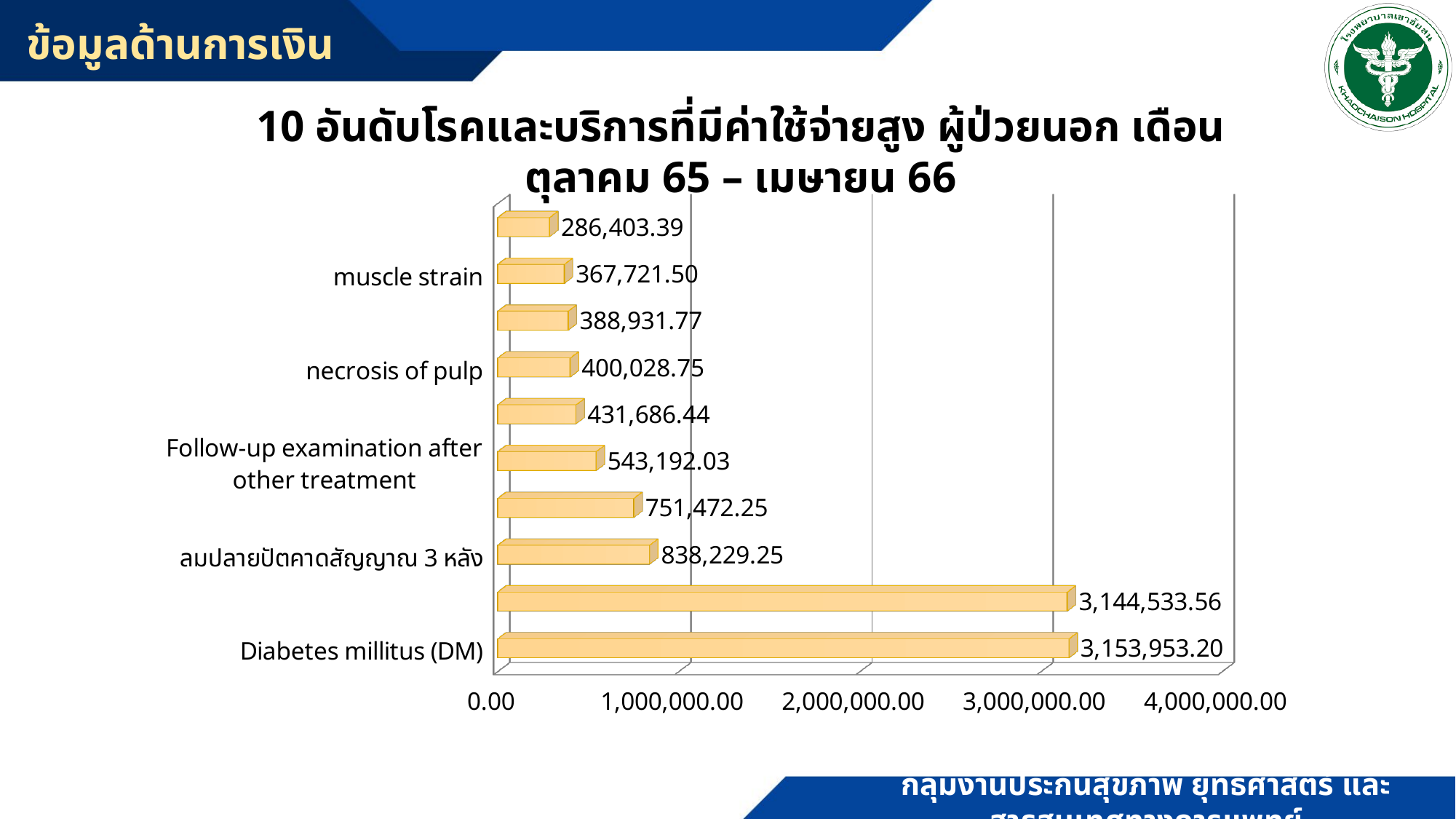
What is the value for ลมปลายปัตคาดสัญญาณ 3 หลัง? 838,229.25 What is the smallest value shown on the chart? 286,403.39 How many bars are plotted on the chart? 10 What is the value for necrosis of pulp? 400,028.75 What is the value for Diabetes millitus (DM)? 3,153,953.20 What kind of chart is shown on the slide? bar chart What is the value for Follow-up examination after other treatment? 543,192.03 Which is larger, the value for necrosis of pulp or the value for muscle strain? necrosis of pulp Is the value for Follow-up examination after other treatment greater or less than 1,000,000.00? less Which category has the highest value? Diabetes millitus (DM) What is the difference between the values for Diabetes millitus (DM) and ลมปลายปัตคาดสัญญาณ 3 หลัง? 2,315,723.95 What is the value for muscle strain? 367,721.50